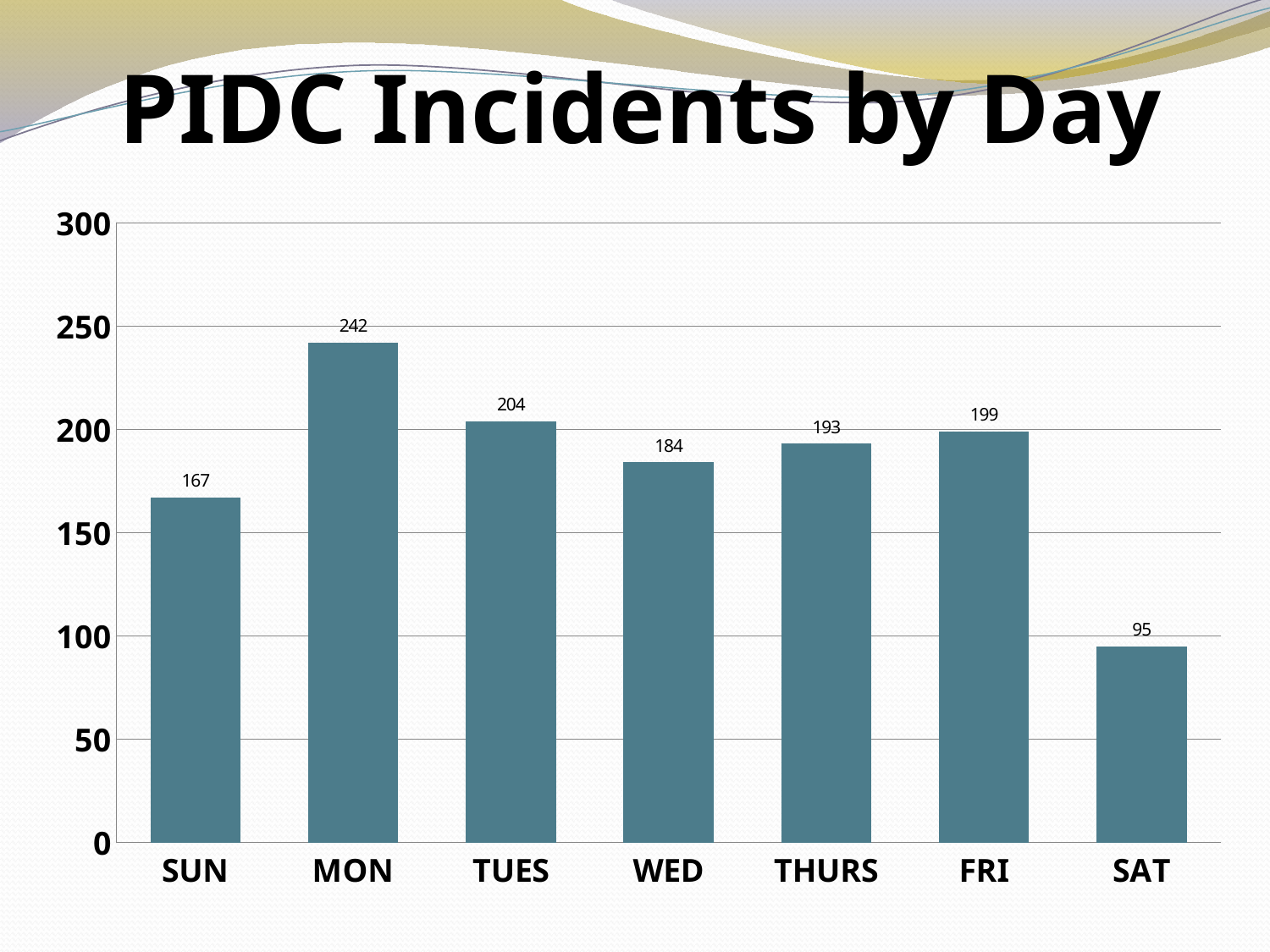
Which day has the lowest number of incidents? SAT How many days are shown on the x axis? 7 Which day has the highest number of incidents? MON What is the difference between the values for MON and SAT? 147 Is the value for SUN greater or less than 150? greater What is the value for MON? 242 Which is larger, the value for FRI or the value for WED? FRI What is the value for SAT? 95 What is the value for WED? 184 What is the difference between the values for TUES and SUN? 37 What is the title of the chart? PIDC Incidents by Day What kind of chart is shown on the slide? bar chart